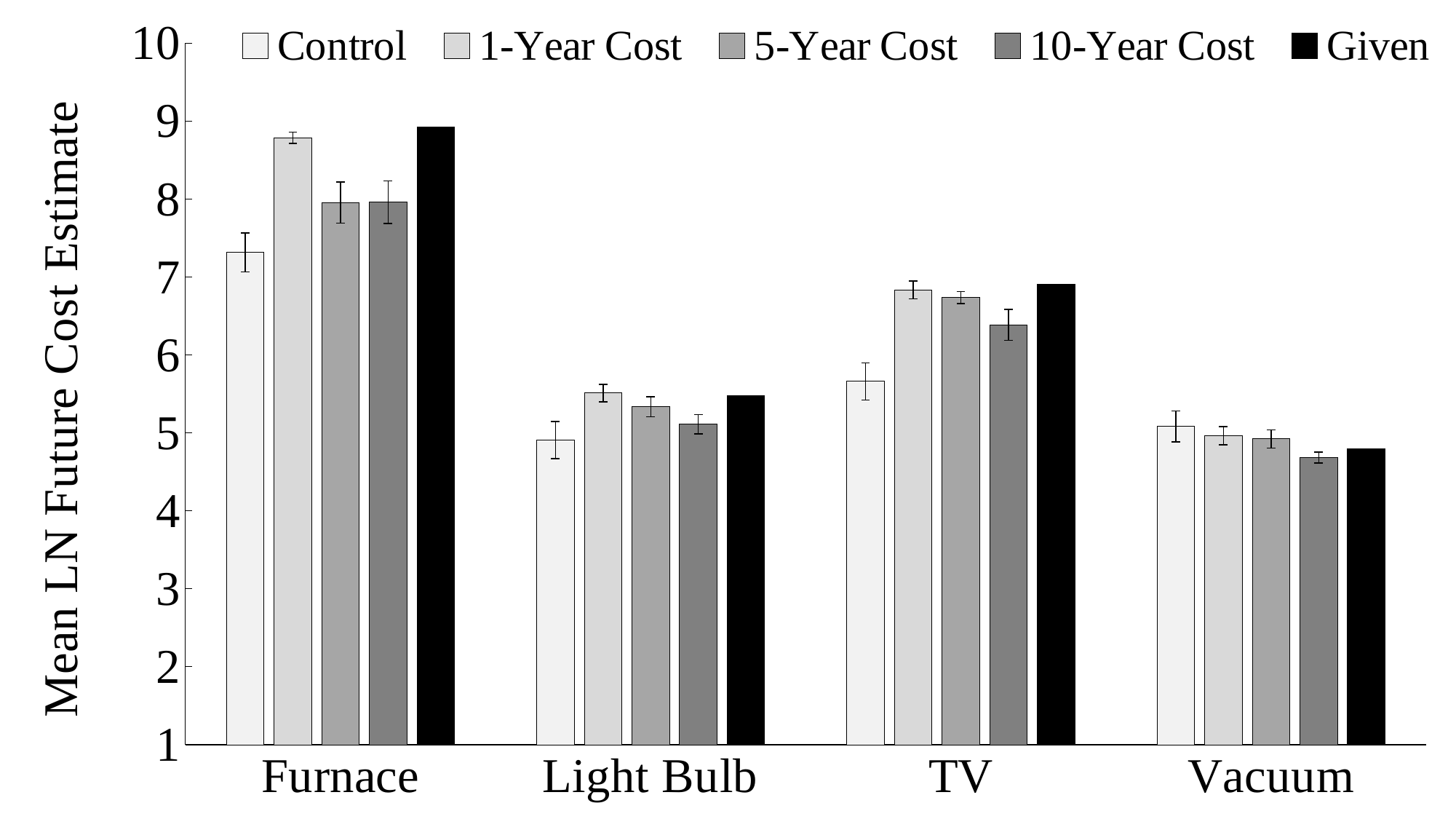
How many product categories are shown on the x axis? 4 Is the 10-Year Cost value for Vacuum greater or less than 5? less For TV, which is larger: the 10-Year Cost bar or the 1-Year Cost bar? 1-Year Cost What kind of chart is shown on the slide? bar chart Which product category has the highest Given bar? Furnace What is the title of the y axis? Mean LN Future Cost Estimate Is the Control value for Furnace greater or less than 7? greater How many series does the legend list? 5 Is the 1-Year Cost value for Furnace greater or less than 8? greater For Furnace, which is larger: the Control bar or the 1-Year Cost bar? 1-Year Cost